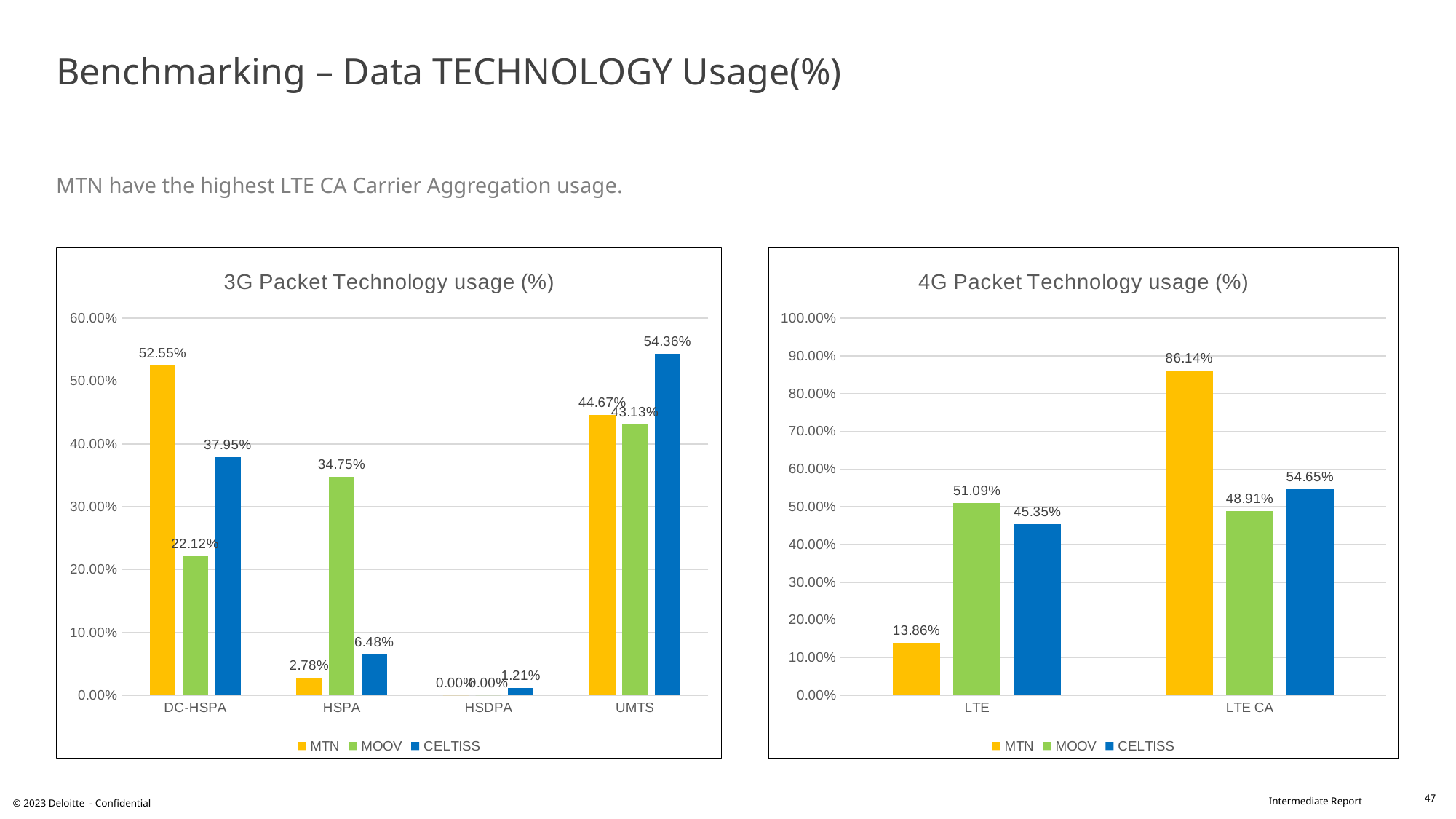
In the 4G Packet Technology usage (%) chart, what is the value for MOOV at LTE? 51.09% In the 4G Packet Technology usage (%) chart, which operator has the lowest value at LTE? MTN In the 3G Packet Technology usage (%) chart, how many technology categories are shown on the x axis? 4 In the 3G Packet Technology usage (%) chart, what is the value for MTN at DC-HSPA? 52.55% In the 4G Packet Technology usage (%) chart, is the value for CELTISS at LTE CA larger or smaller than the value for MOOV at LTE CA? larger In the 4G Packet Technology usage (%) chart, what is the value for MTN at LTE CA? 86.14% In the 3G Packet Technology usage (%) chart, what is the value for MOOV at HSPA? 34.75% In the 4G Packet Technology usage (%) chart, what is the difference between MTN and MOOV at LTE CA? 37.23% In the 3G Packet Technology usage (%) chart, what is the difference between MTN and MOOV at DC-HSPA? 30.43% In the 3G Packet Technology usage (%) chart, which operator has the highest value at UMTS? CELTISS How many series does the legend of the 4G Packet Technology usage (%) chart list? 3 In the 3G Packet Technology usage (%) chart, what is the value for CELTISS at HSDPA? 1.21%